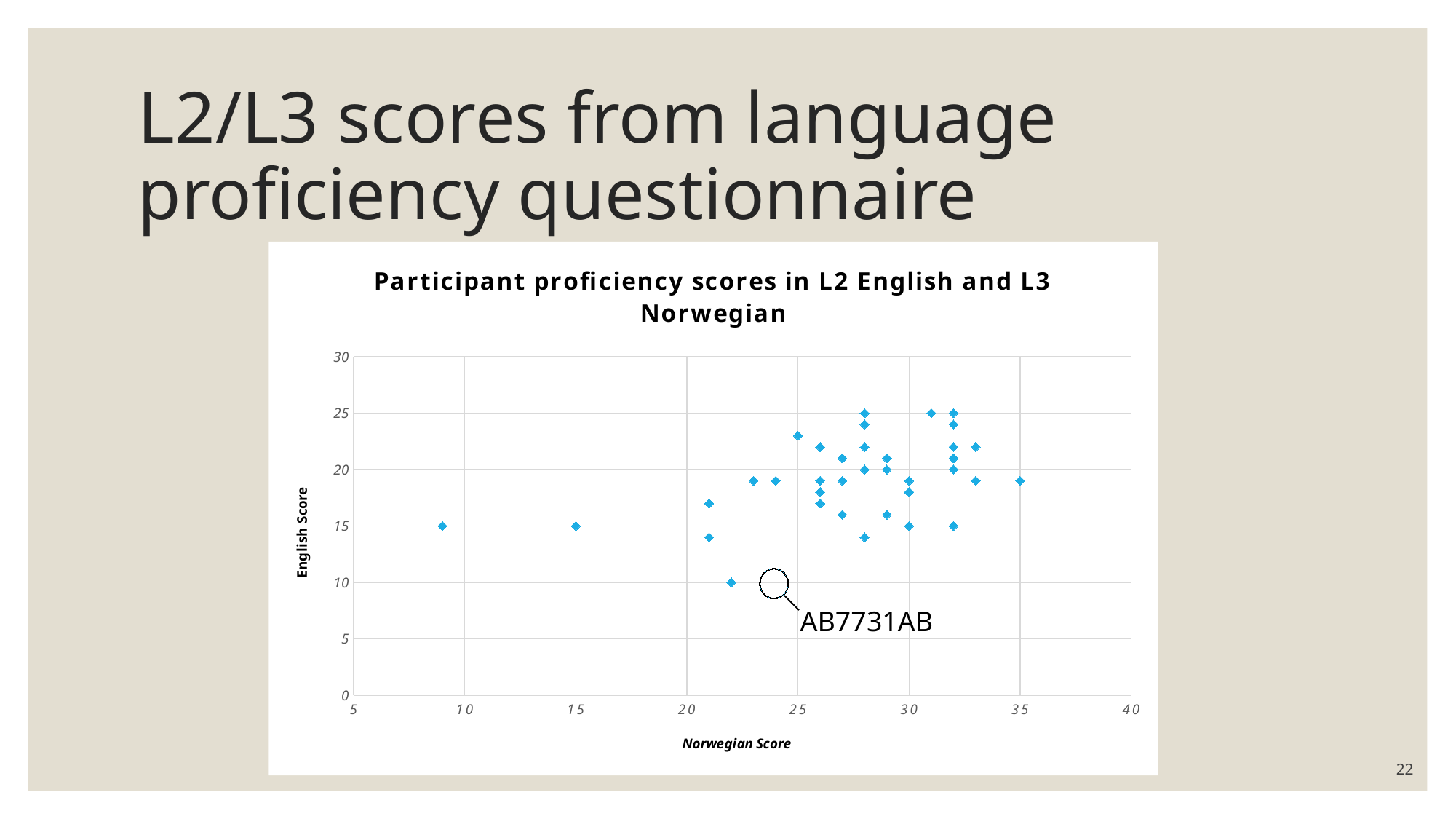
Is the Norwegian Score of the point with the lowest English Score greater or less than 25? less What is the title of the chart? Participant proficiency scores in L2 English and L3 Norwegian What is the highest Norwegian Score plotted on the chart? 35 What is the English Score of the leftmost point on the chart? 15 What label is shown on the x axis of the chart? Norwegian Score Is the Norwegian Score of the rightmost point greater or less than 30? greater What is the lowest English Score plotted on the chart? 10 Which is larger: the highest English Score plotted or the lowest English Score plotted? the highest English Score Is the English Score of the leftmost point greater or less than 20? less What is the highest English Score plotted on the chart? 25 What kind of chart is shown on the slide? scatter chart Do English Scores generally rise or fall as Norwegian Scores increase along the x axis? rise